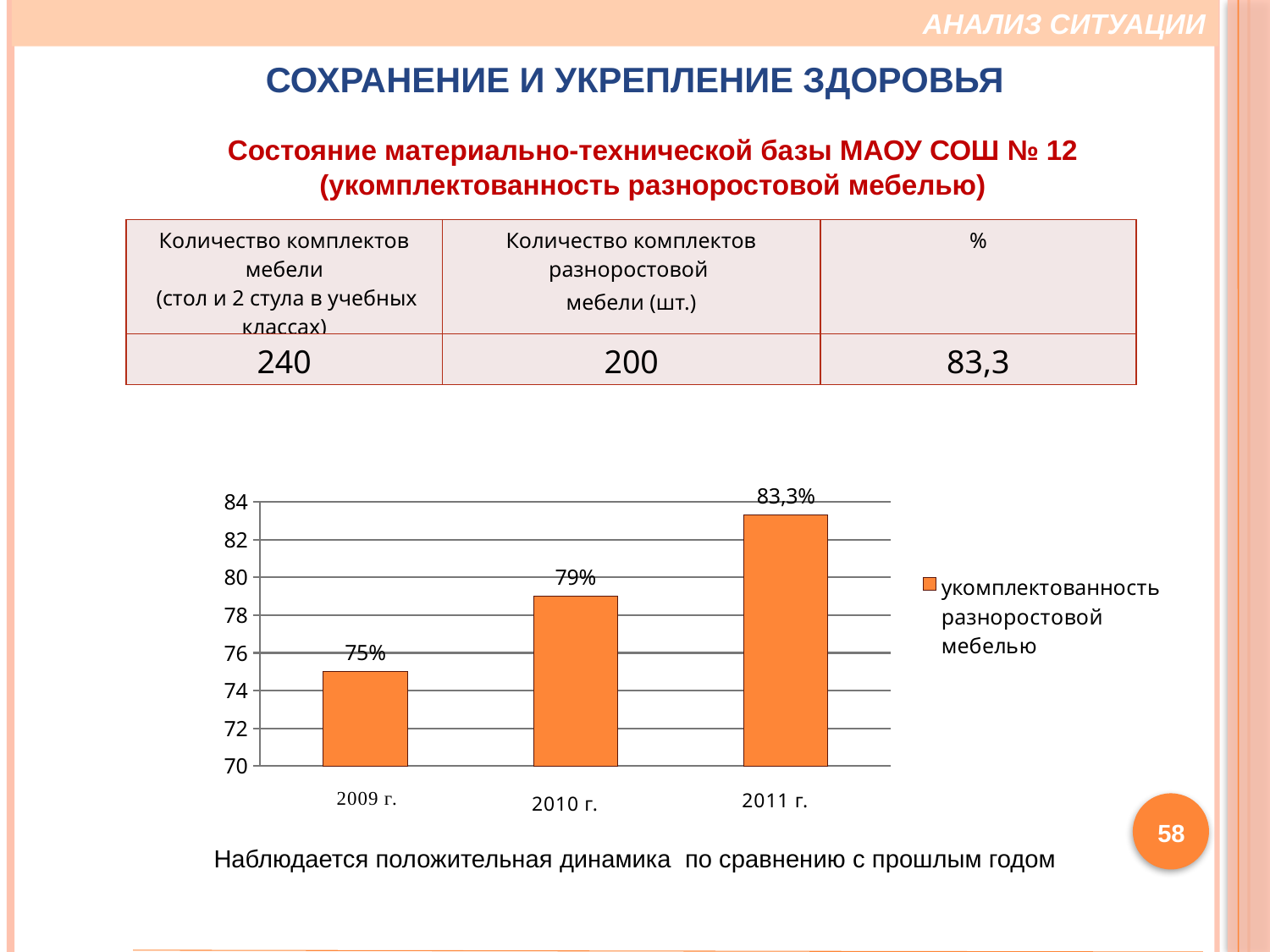
What kind of chart is shown? bar chart What is the value for 2010 г.? 79% What is the value for 2009 г.? 75% Is the value for 2010 г. greater or less than 78? greater Which year has the highest value? 2011 г. How many years are shown on the x axis? 3 Which is larger, the value for 2011 г. or the value for 2010 г.? 2011 г. What is the difference between the values for 2010 г. and 2009 г.? 4% What is the value for 2011 г.? 83,3% How many series does the legend list? 1 Which year has the lowest value? 2009 г. Do the values rise or fall from 2009 г. to 2011 г.? rise